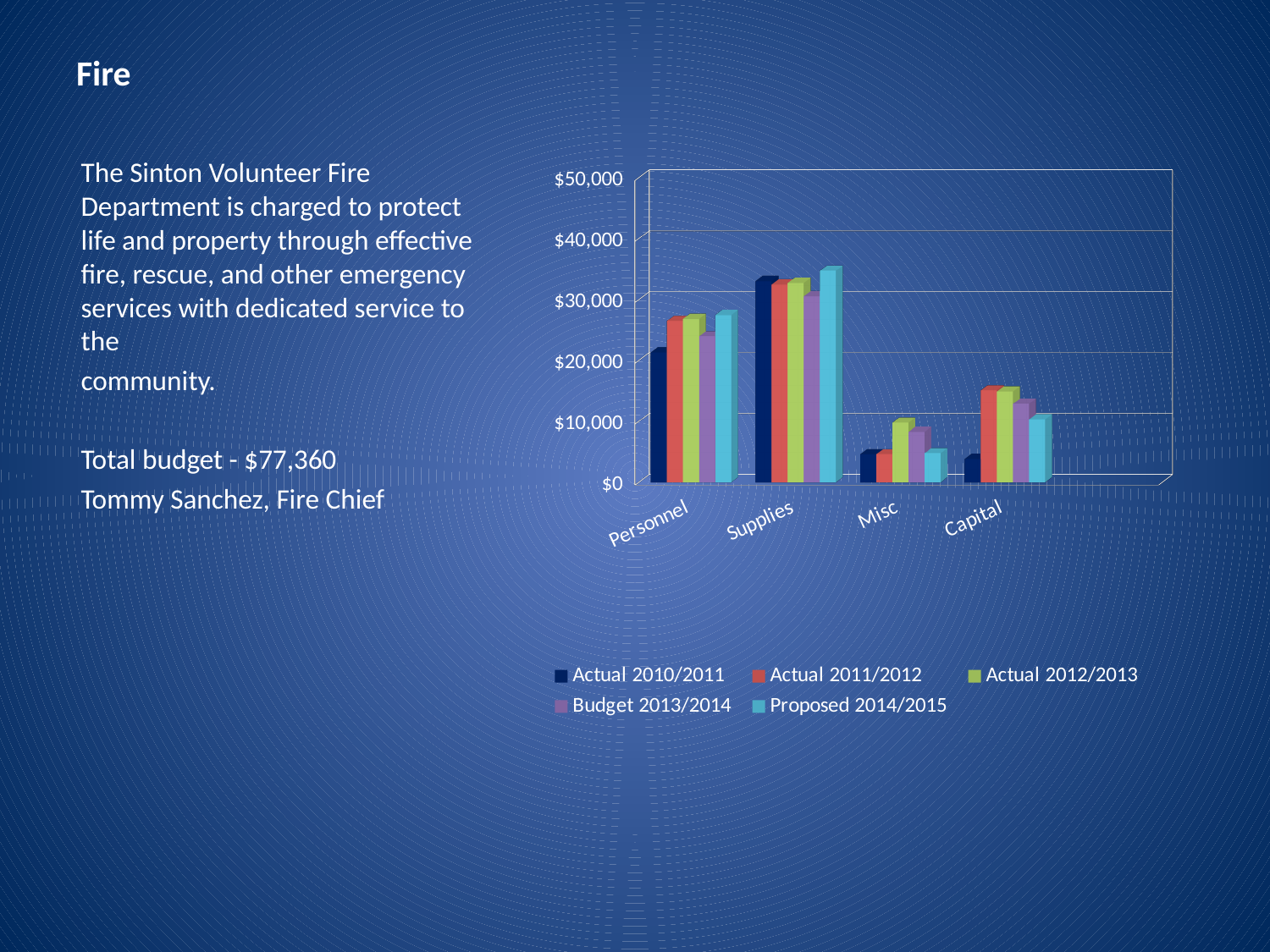
Is the Proposed 2014/2015 value for Personnel greater or less than $30,000? less Which series is shown in light blue in the chart legend? Proposed 2014/2015 How many categories are shown on the x axis of the chart? 4 For Actual 2011/2012, which is larger: Misc or Capital? Capital Is the Actual 2011/2012 value for Capital greater or less than $10,000? greater What is the highest value labelled on the vertical axis of the chart? $50,000 What kind of chart is shown on the slide? Bar chart For Actual 2011/2012, which is larger: Supplies or Personnel? Supplies Which category has the tallest bars in the chart? Supplies Is the Proposed 2014/2015 value for Supplies greater or less than $30,000? greater How many series does the chart legend list? 5